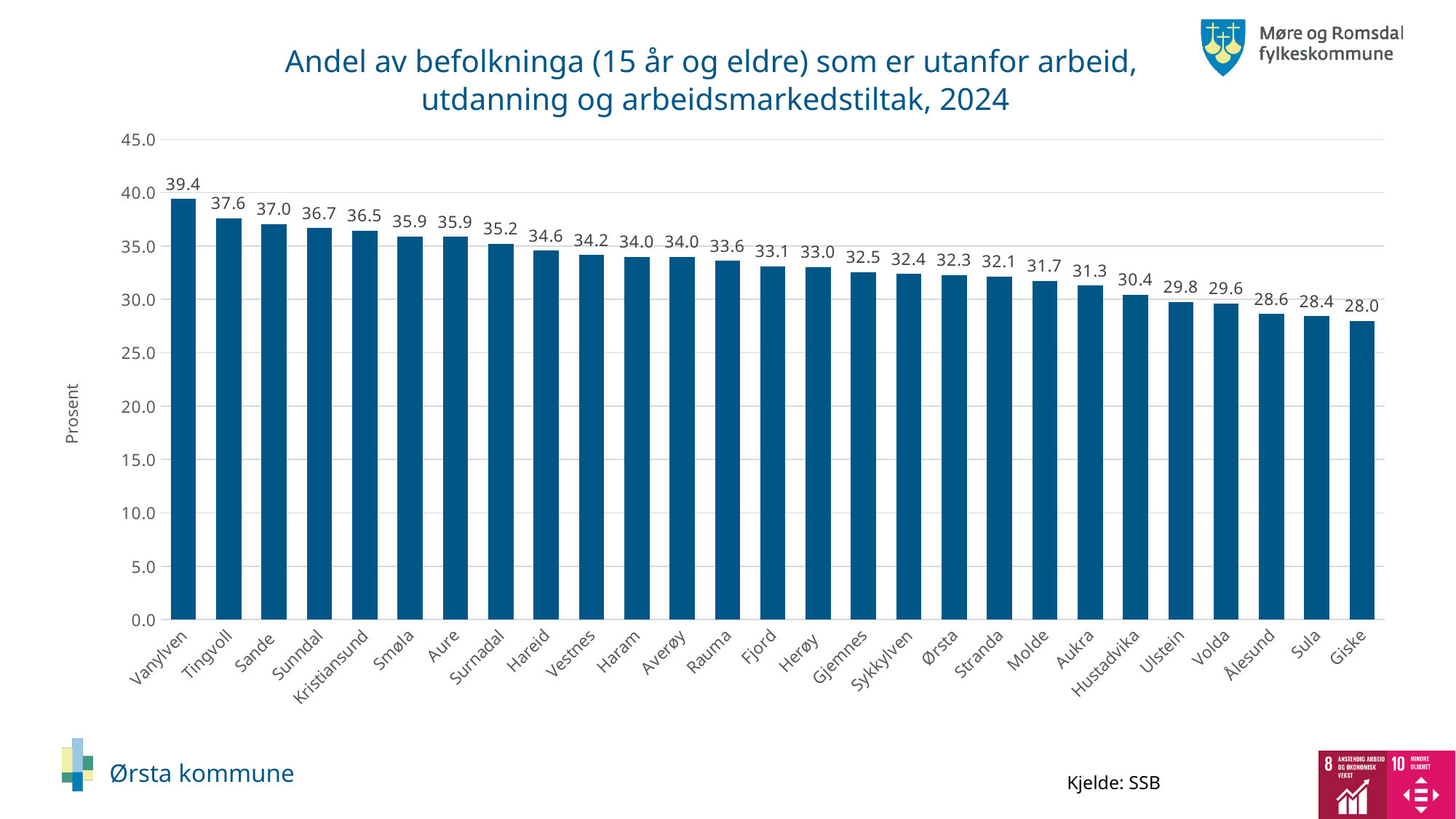
Is the value for Hustadvika greater or less than 35.0? less What is the difference between the values for Vanylven and Giske? 11.4 What is the label on the vertical axis? Prosent Which municipality has the lowest value? Giske What is the value for Ørsta? 32.3 Which municipality has the highest value? Vanylven What kind of chart is shown on the slide? bar chart What is the value for Kristiansund? 36.5 What is the difference between the values for Ørsta and Volda? 2.7 What is the value for Molde? 31.7 How many municipalities are shown in the chart? 27 Which is larger, the value for Tingvoll or the value for Ålesund? Tingvoll